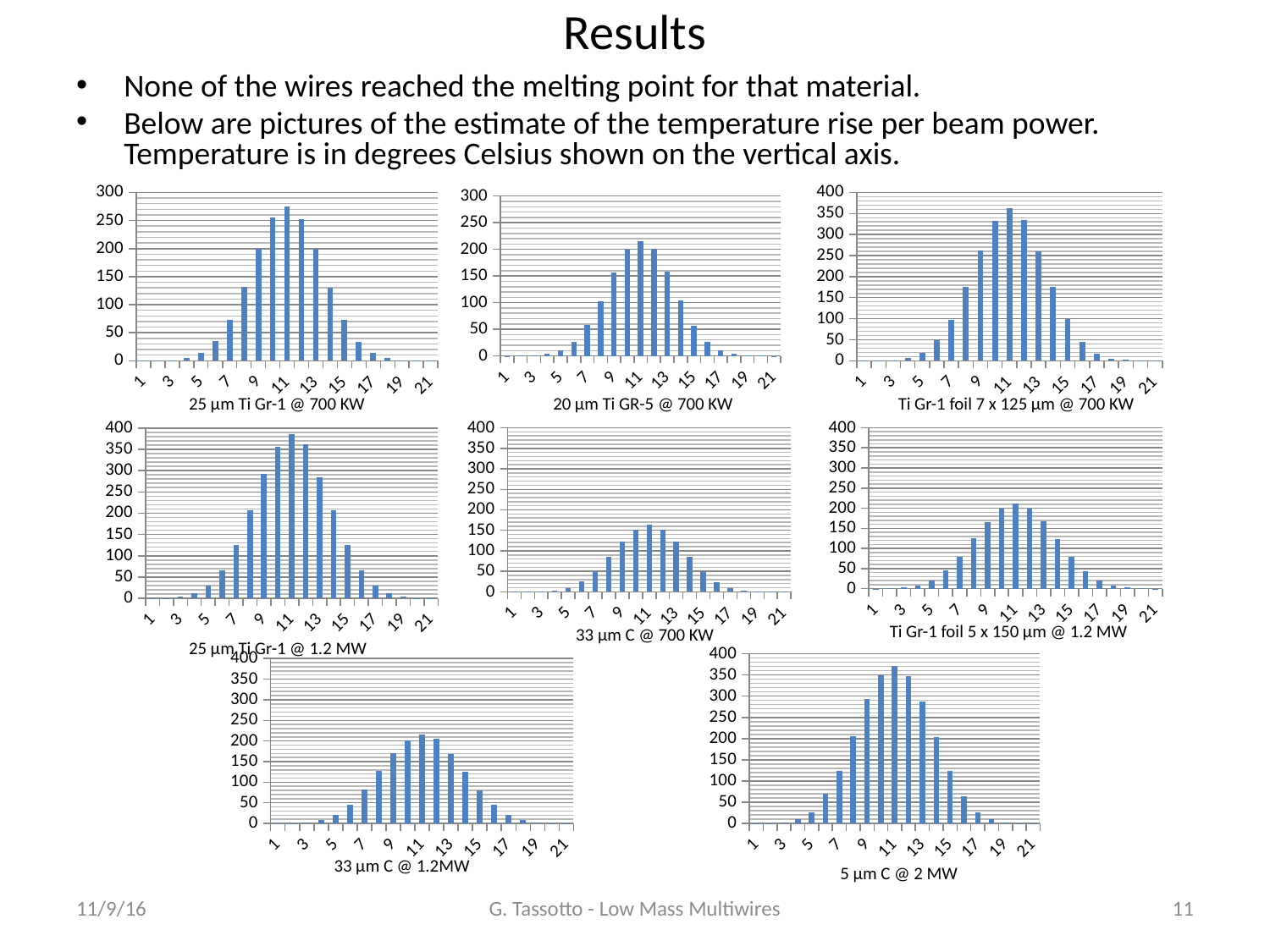
In the 'Ti Gr-1 foil 5 x 150 µm @ 1.2 MW' chart, do the values rise or fall from category 1 to category 11? rise In the '20 µm Ti GR-5 @ 700 KW' chart, is the value for category 11 greater or less than 250? less In the '5 µm C @ 2 MW' chart, which category has the highest bar? 11 In the '25 µm Ti Gr-1 @ 700 KW' chart, is the value for category 11 greater or less than 250? greater In the '25 µm Ti Gr-1 @ 1.2 MW' chart, is the value for category 11 greater or less than 350? greater In the '25 µm Ti Gr-1 @ 700 KW' chart, which category has the highest bar? 11 How many charts are shown on the slide? 8 What is the highest value shown on the vertical axis of the '25 µm Ti Gr-1 @ 1.2 MW' chart? 400 What kind of chart is the '25 µm Ti Gr-1 @ 700 KW' chart? bar chart